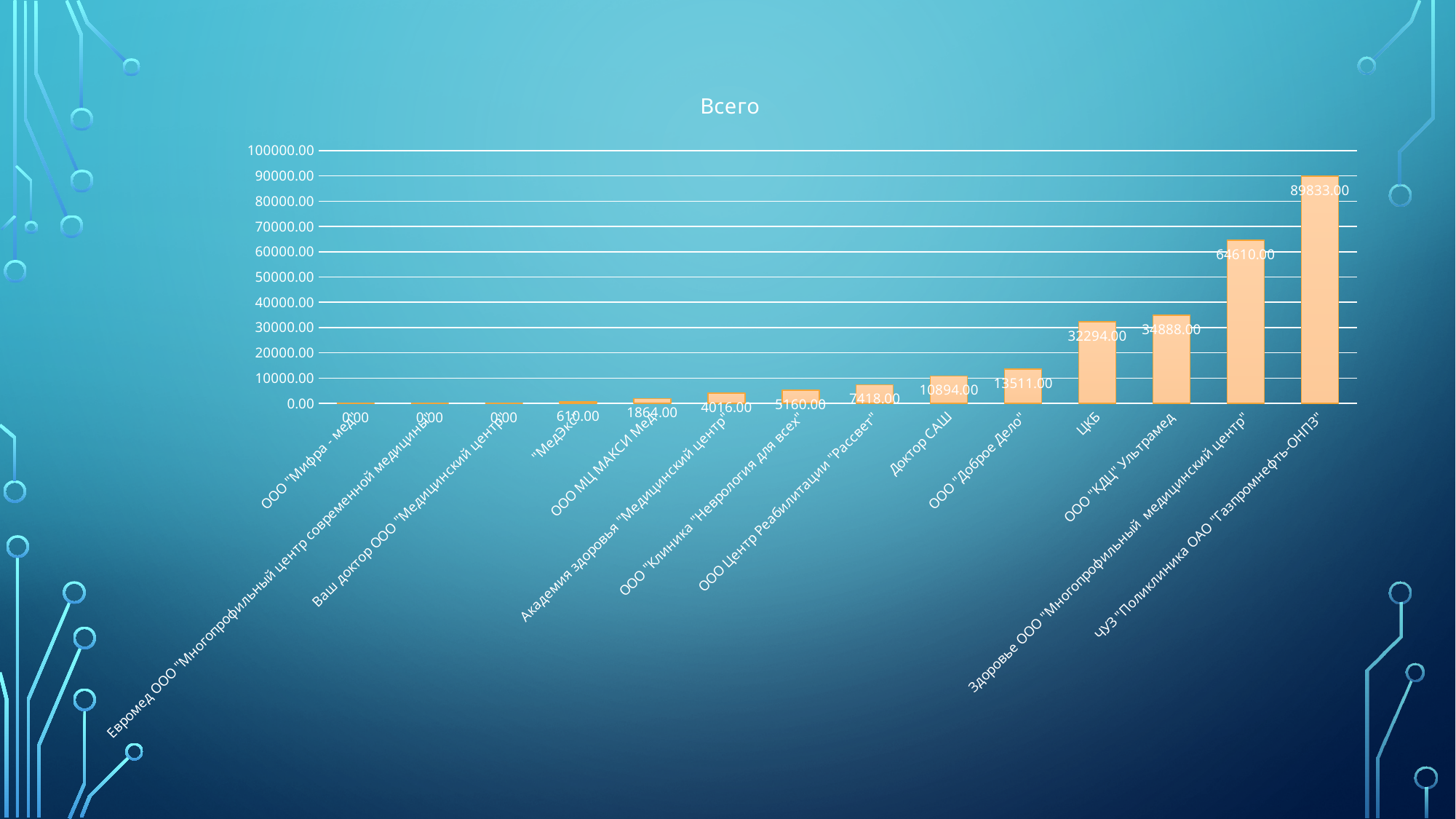
What is the title of the chart? Всего Which is larger, the value for ООО "Доброе Дело" or the value for ООО Центр Реабилитации "Рассвет"? ООО "Доброе Дело" Which category has the highest value? ЧУЗ "Поликлиника ОАО "Газпромнефть-ОНПЗ" What is the value for ЦКБ? 32294.00 Is the value for ЧУЗ "Поликлиника ОАО "Газпромнефть-ОНПЗ" greater or less than 80000.00? greater What is the value for "МедЭкс"? 610.00 What is the difference between the values for ООО "КДЦ" Ультрамед and ЦКБ? 2594.00 Do the values generally rise or fall from left to right along the x axis? rise What is the value for Здоровье ООО "Многопрофильный медицинский центр"? 64610.00 How many categories are plotted in the chart? 14 What is the value for Доктор САШ? 10894.00 What kind of chart is shown on the slide? bar chart